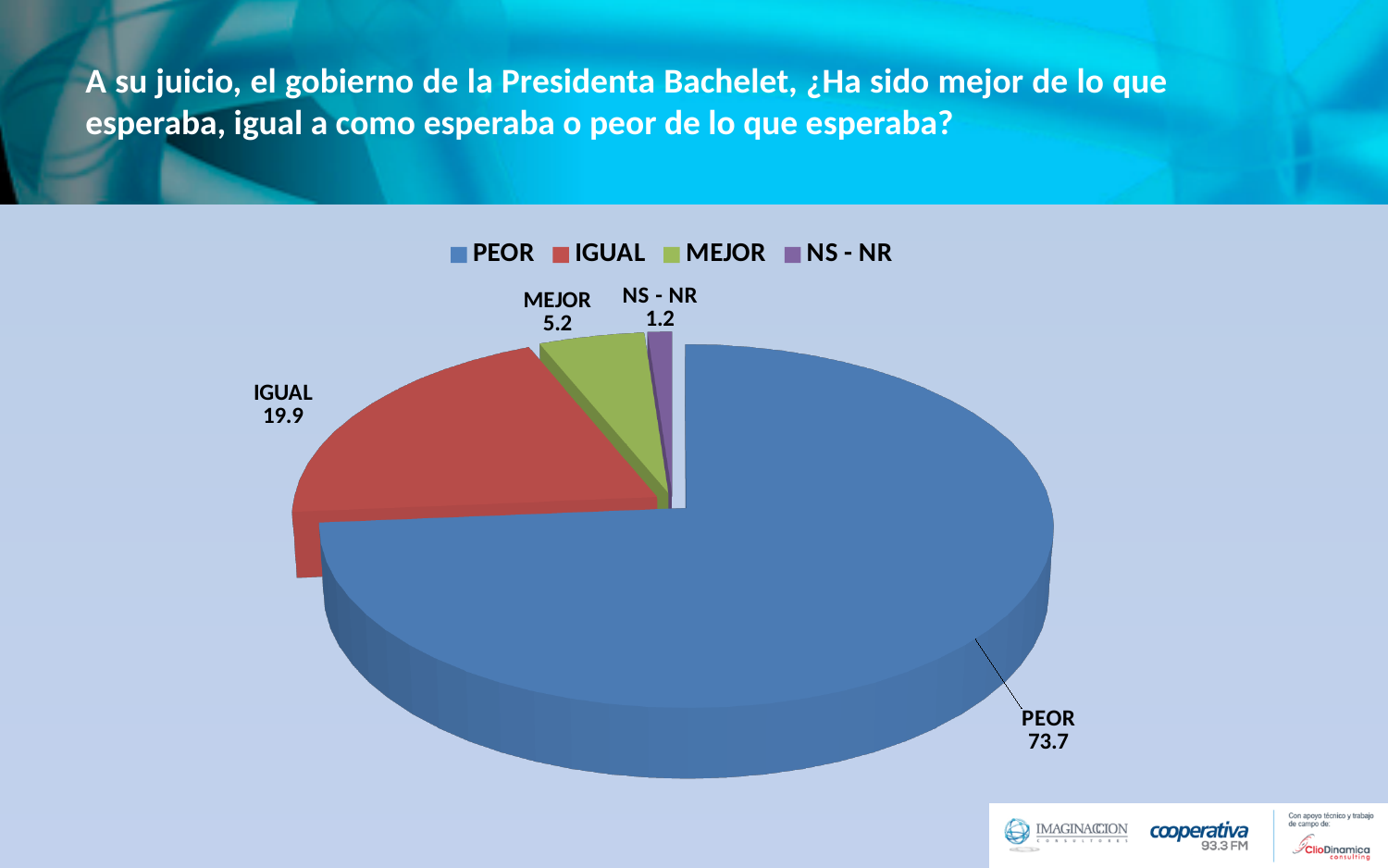
What is the difference between the values for PEOR and IGUAL? 53.8 What is the value for PEOR? 73.7 What kind of chart is shown on the slide? Pie chart Which category has the largest slice? PEOR What is the value for MEJOR? 5.2 What is the value for NS - NR? 1.2 What is the difference between the values for MEJOR and NS - NR? 4.0 What is the value for IGUAL? 19.9 How many categories does the pie chart show? 4 Which category has the smallest slice? NS - NR Which is larger, the value for IGUAL or the value for MEJOR? IGUAL What colour is the PEOR slice? Blue